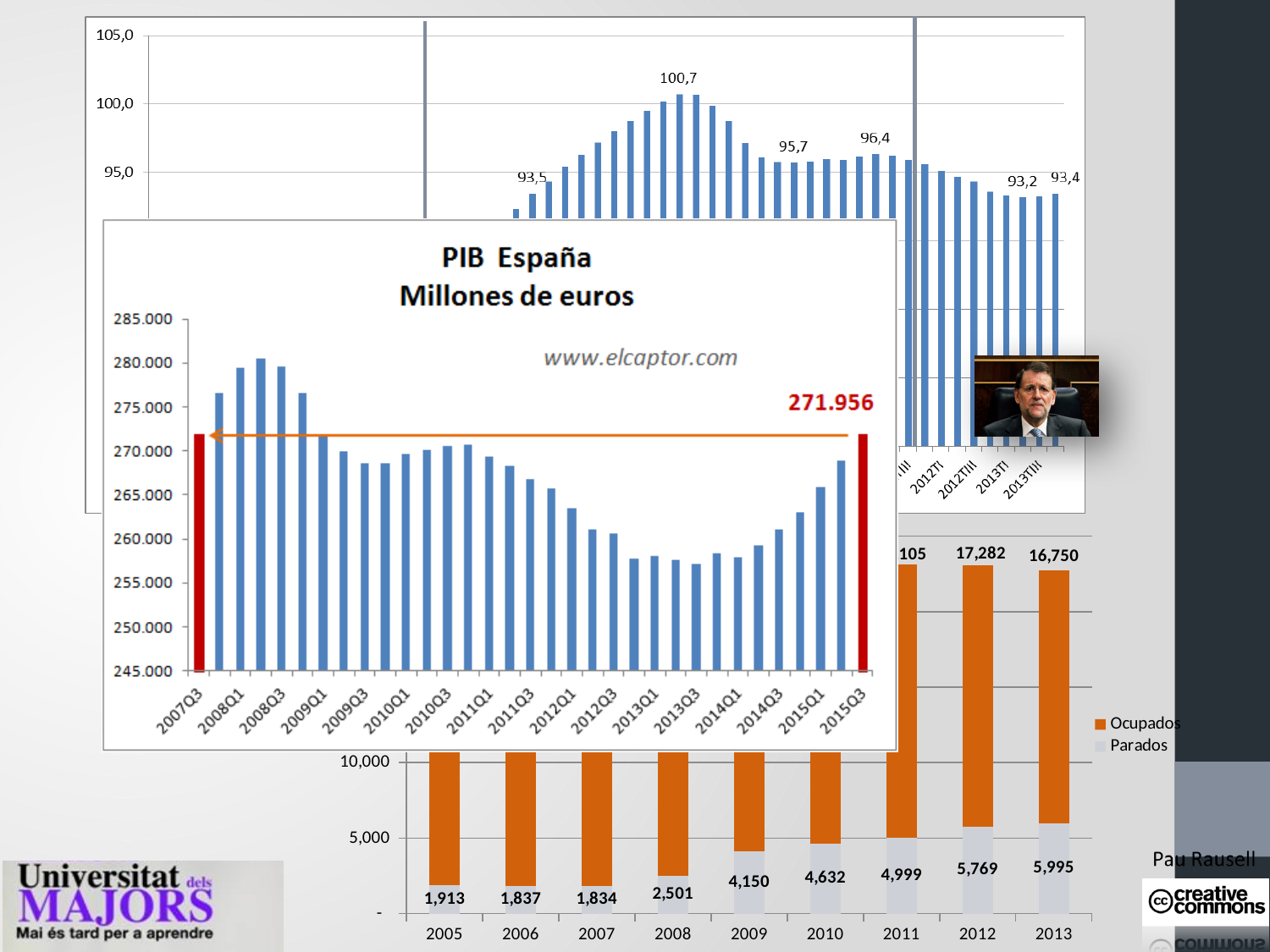
In the chart titled 'PIB España Millones de euros', what value is labelled for 2015Q3? 271.956 In the bottom stacked bar chart, which year has the highest Parados value? 2013 In the bottom stacked bar chart, what is the Ocupados value for 2013? 16,750 How many series does the legend of the bottom stacked bar chart list? 2 What kind of chart is the 'PIB España Millones de euros' chart? bar chart In the 'PIB España Millones de euros' chart, is the value for 2013Q3 greater or less than 260.000? less In the bottom stacked bar chart, what is the Parados value for 2005? 1,913 In the 'PIB España Millones de euros' chart, do the values rise or fall from 2008Q1 to 2013Q3? fall In the bottom stacked bar chart, what is the difference between the Parados values for 2013 and 2005? 4,082 In the bottom stacked bar chart, what is the total of the 2013 bar (Ocupados plus Parados)? 22,745 In the top chart, what is the highest labelled value? 100,7 In the bottom stacked bar chart, is the Ocupados value larger in 2012 or 2013? 2012